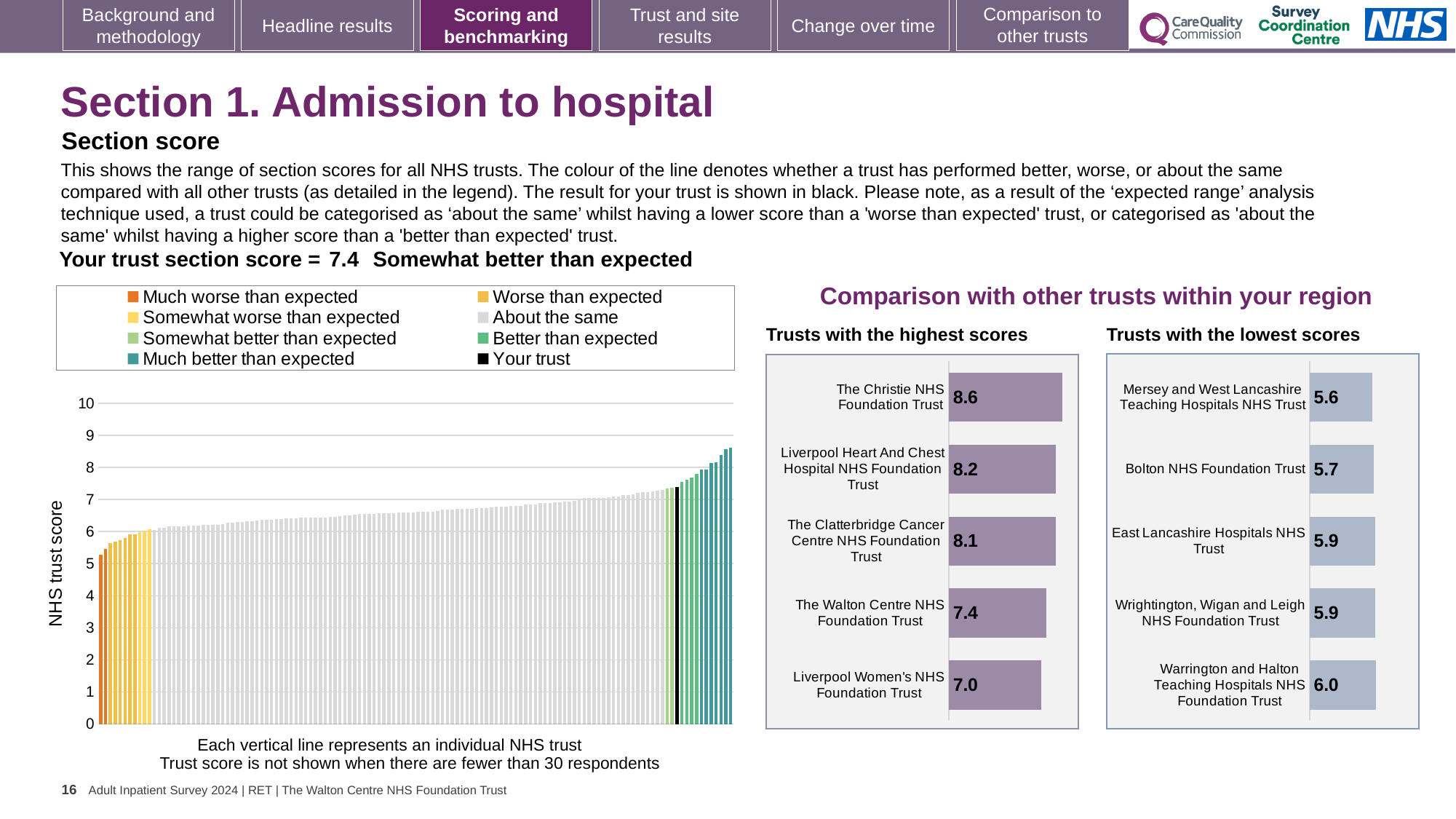
In the 'Trusts with the highest scores' chart, which has a higher score: Liverpool Heart And Chest Hospital NHS Foundation Trust or The Clatterbridge Cancer Centre NHS Foundation Trust? Liverpool Heart And Chest Hospital NHS Foundation Trust How many trusts are shown in the 'Trusts with the lowest scores' chart? 5 In the 'Trusts with the highest scores' chart, which trust has the highest score? The Christie NHS Foundation Trust In the 'Trusts with the lowest scores' chart, what is the difference between the scores of Warrington and Halton Teaching Hospitals NHS Foundation Trust and Mersey and West Lancashire Teaching Hospitals NHS Trust? 0.4 In the 'Trusts with the highest scores' chart, what is the difference between the scores of The Christie NHS Foundation Trust and The Walton Centre NHS Foundation Trust? 1.2 In the 'Trusts with the lowest scores' chart, which trust has the lowest score? Mersey and West Lancashire Teaching Hospitals NHS Trust In the 'Trusts with the lowest scores' chart, what is the score for Bolton NHS Foundation Trust? 5.7 In the 'Trusts with the highest scores' chart, what is the score for Liverpool Women's NHS Foundation Trust? 7.0 In the 'Trusts with the highest scores' chart, what is the score for The Christie NHS Foundation Trust? 8.6 In the main 'NHS trust score' chart, do the trust scores rise or fall from left to right? Rise How many entries does the legend of the main 'NHS trust score' chart list? 8 What kind of chart is the main 'NHS trust score' chart on the left of the slide? Bar chart